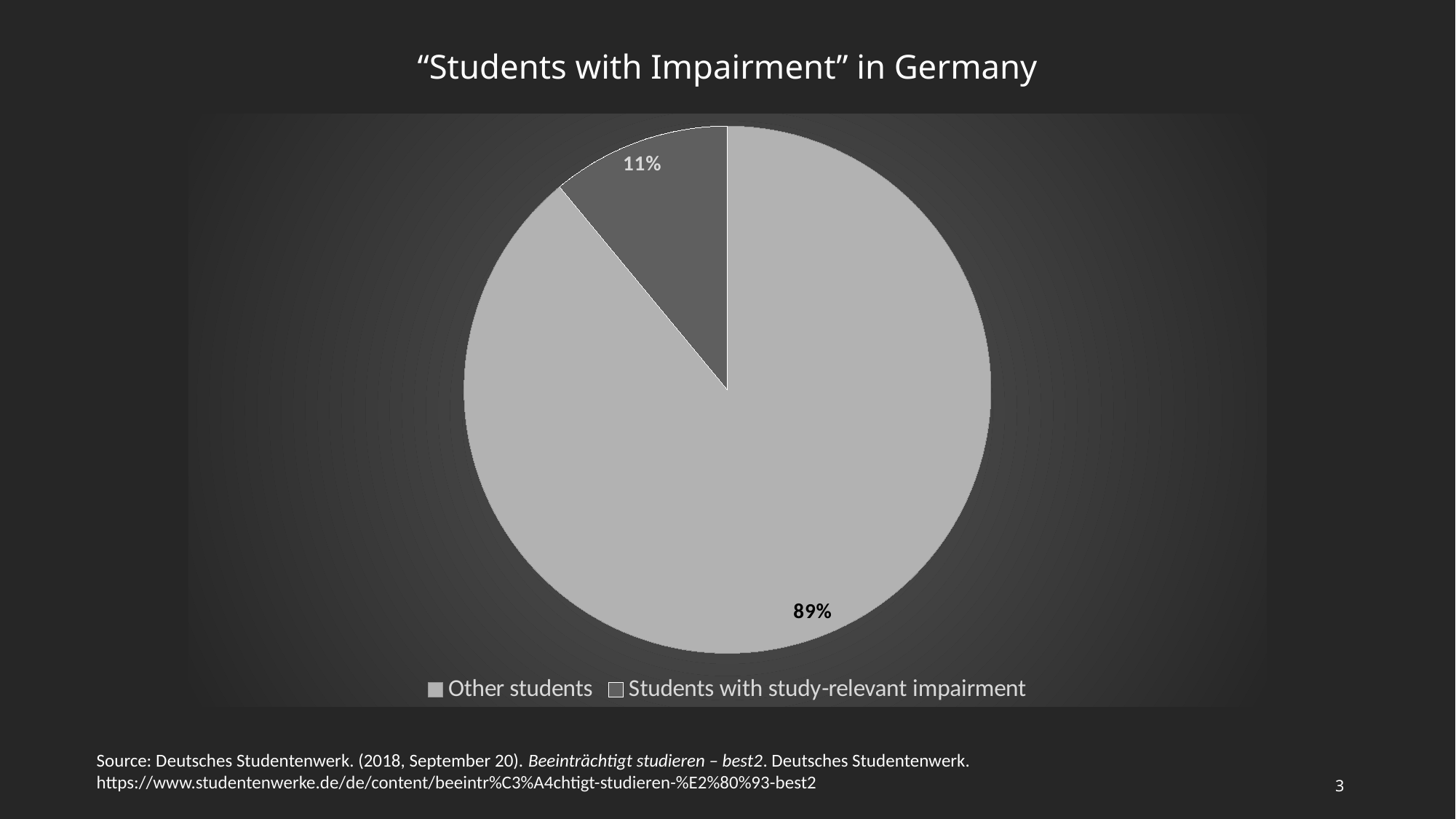
What kind of chart is shown on the slide? Pie chart How many slices does the pie chart have? 2 What share of the pie is labelled for "Other students"? 89% How many entries does the legend list? 2 Which slice of the pie is the smallest? Students with study-relevant impairment Which slice of the pie is the largest? Other students Which legend entry is shown in the darker grey colour? Students with study-relevant impairment Which is larger: the share for "Other students" or the share for "Students with study-relevant impairment"? Other students What share of the pie is labelled for "Students with study-relevant impairment"? 11% What is the difference in percentage points between the "Other students" slice and the "Students with study-relevant impairment" slice? 78 percentage points What is the title of the chart? "Students with Impairment" in Germany